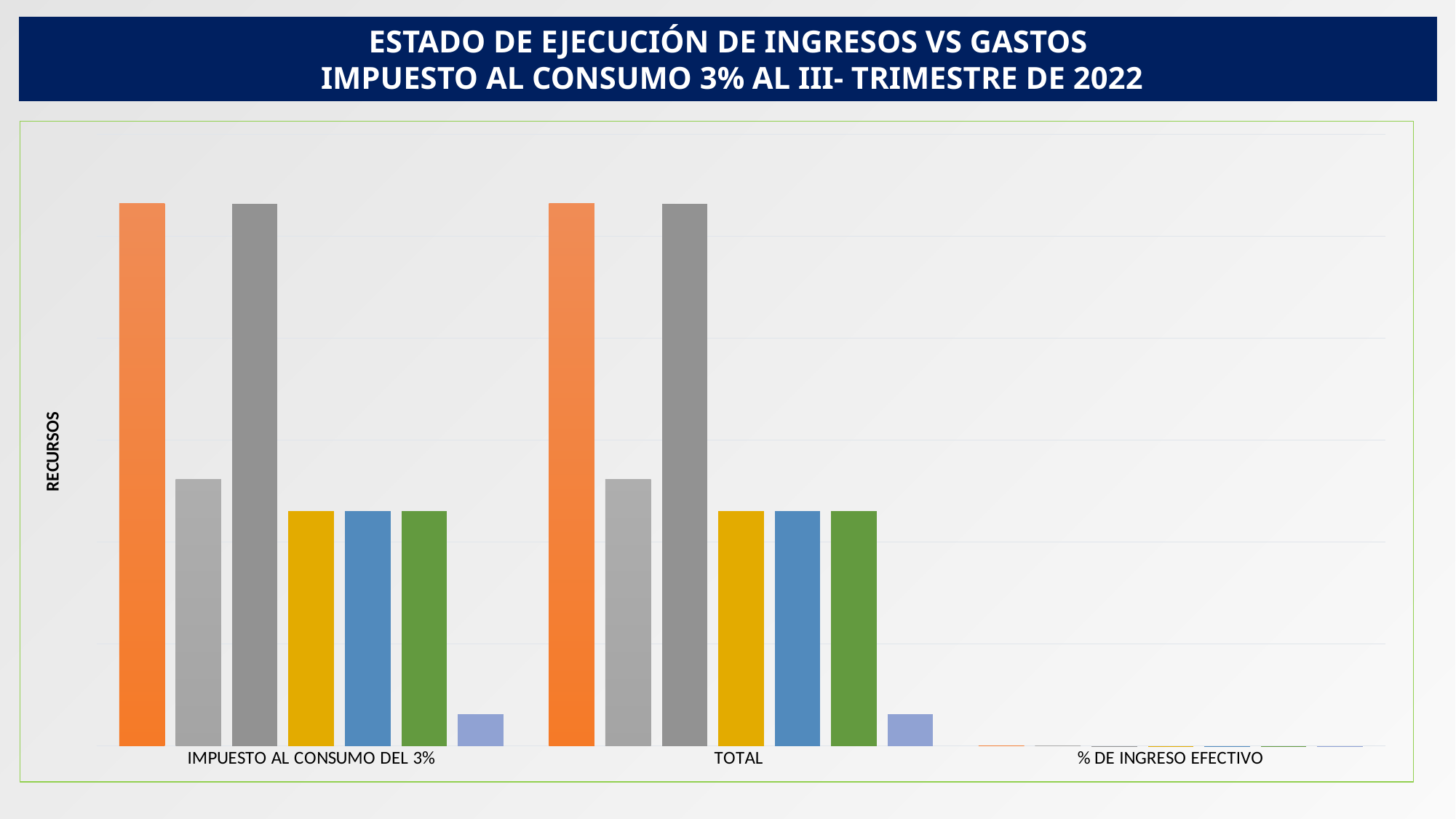
What is the title shown above the chart? ESTADO DE EJECUCIÓN DE INGRESOS VS GASTOS IMPUESTO AL CONSUMO 3% AL III- TRIMESTRE DE 2022 How many categories are shown on the x axis of the chart? 3 What kind of chart is shown on the slide? bar chart In the IMPUESTO AL CONSUMO DEL 3% category, which is taller, the orange bar or the gold bar? the orange bar What is the label of the middle category on the x axis? TOTAL Which category has the shortest bars in the chart? % DE INGRESO EFECTIVO How many bars are plotted for the TOTAL category? 7 In the IMPUESTO AL CONSUMO DEL 3% category, which is taller, the blue bar or the light gray bar? the light gray bar What is the label on the vertical axis of the chart? RECURSOS In the TOTAL category, which is taller, the light gray bar or the dark gray bar? the dark gray bar